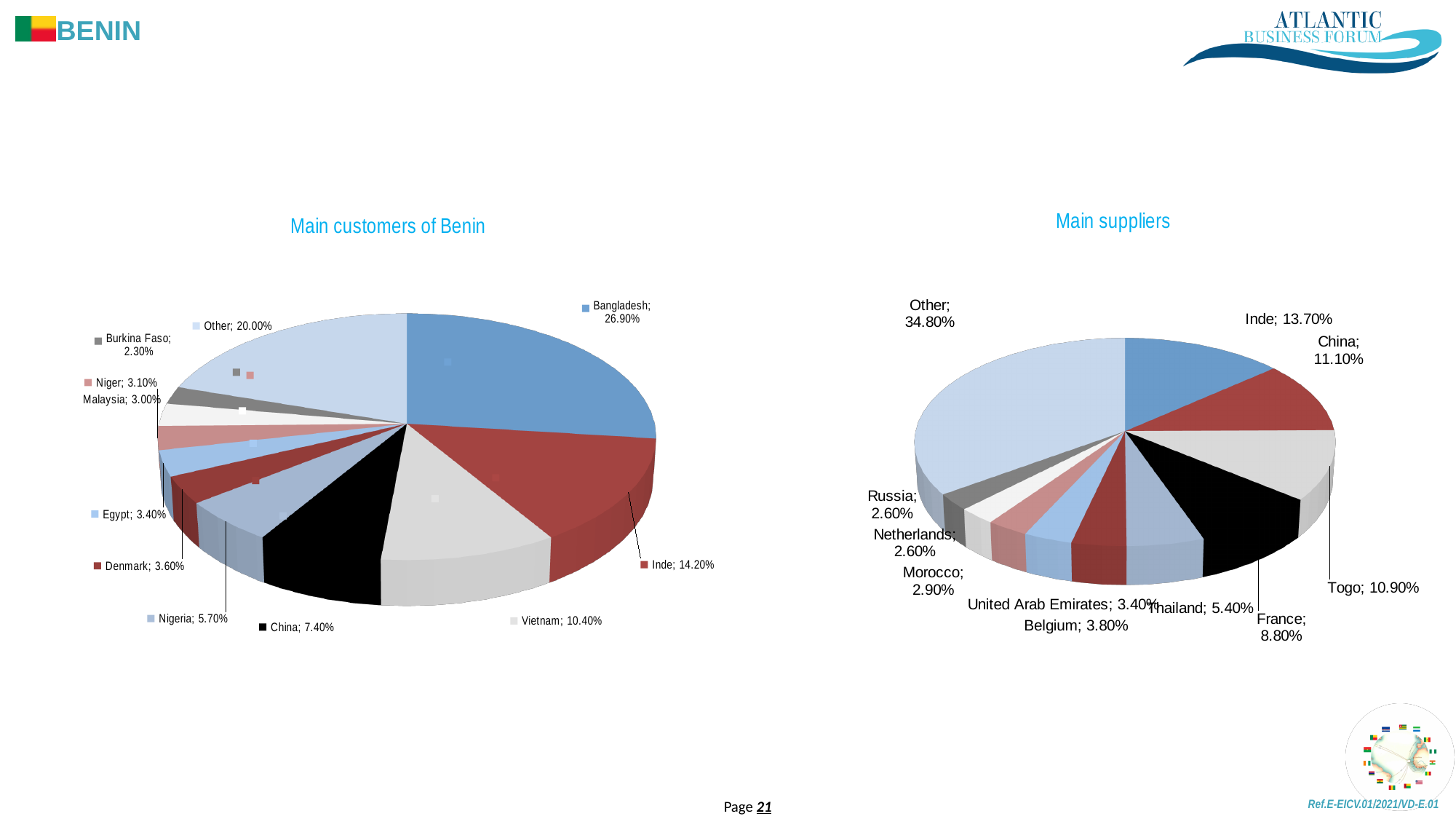
In the 'Main customers of Benin' chart, what is the value for Vietnam? 10.40% In the 'Main customers of Benin' chart, which category has the smallest share? Burkina Faso In the 'Main suppliers' chart, what share does France have? 8.80% What type of chart is used for 'Main suppliers'? Pie chart In the 'Main customers of Benin' chart, how many slices does the pie have? 11 In the 'Main customers of Benin' chart, what is the difference between the shares of Inde and China? 6.80% In the 'Main suppliers' chart, what is the value for Togo? 10.90% In the 'Main suppliers' chart, what is the value for the 'Other' slice? 34.80% In the 'Main suppliers' chart, which is larger, the share for China or the share for Thailand? China In the 'Main customers of Benin' chart, which named country (excluding 'Other') has the largest share? Bangladesh In the 'Main customers of Benin' chart, what share does Bangladesh have? 26.90% In the 'Main suppliers' chart, what is the difference between the shares of Inde and China? 2.60%